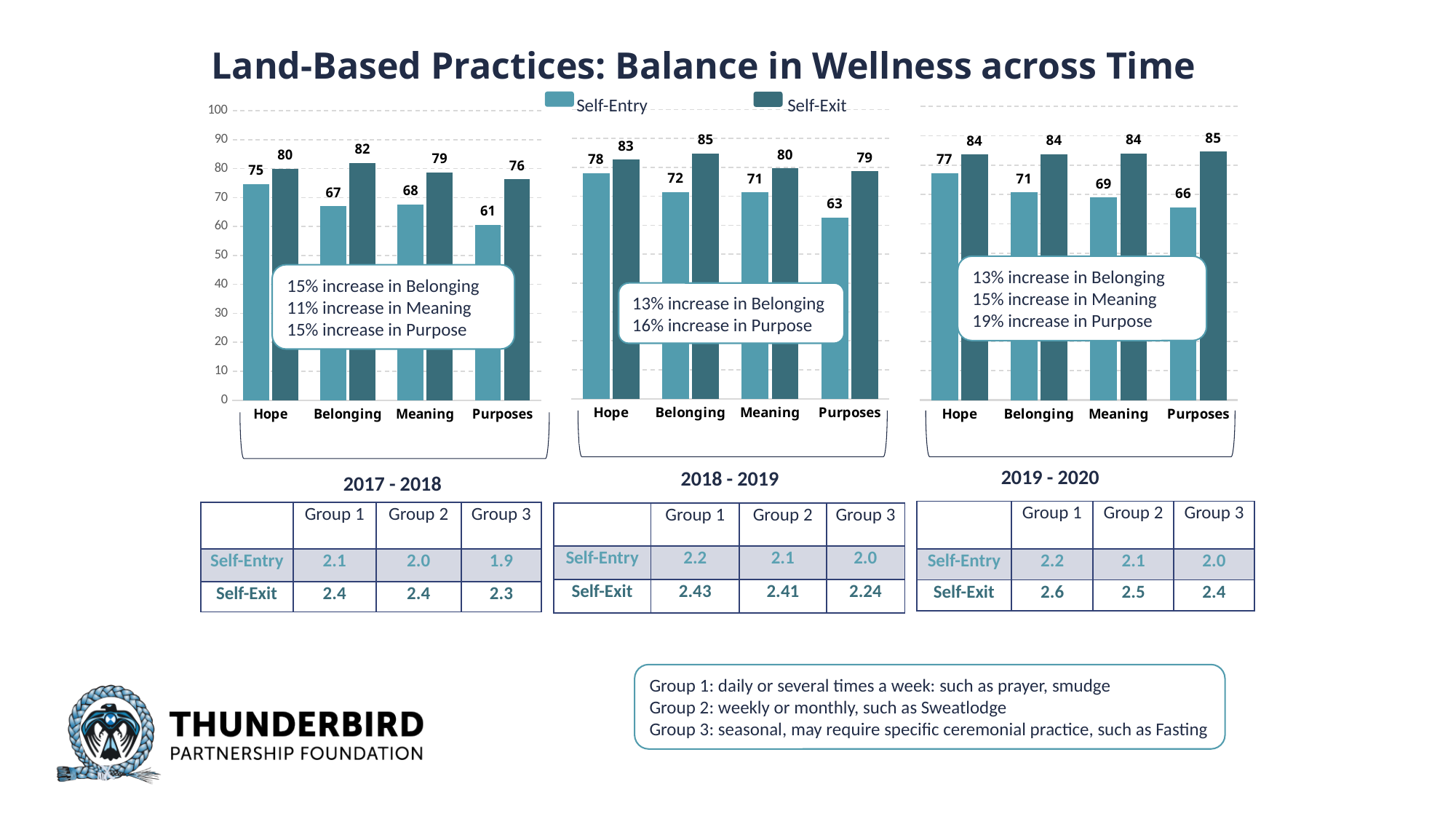
In the 2018 - 2019 chart, what is the difference between the Self-Exit and Self-Entry values for Purposes? 16 In the 2018 - 2019 chart, what is the Self-Exit value for Belonging? 85 In the 2018 - 2019 chart, is the Self-Entry value for Purposes greater or less than 70? less In the 2017 - 2018 chart, what is the Self-Entry value for Hope? 75 How many series does the legend list for the charts? 2 In the 2019 - 2020 chart, which category has the highest Self-Exit value? Purposes In the 2019 - 2020 chart, what is the Self-Entry value for Purposes? 66 In the 2017 - 2018 chart, which category has the lowest Self-Entry value? Purposes In the 2019 - 2020 chart, which is larger: the Self-Entry value for Hope or the Self-Entry value for Meaning? Hope In the 2017 - 2018 chart, what is the difference between the Self-Exit and Self-Entry values for Belonging? 15 What kind of chart is the 2017 - 2018 chart? Bar chart How many categories are shown on the x axis of the 2018 - 2019 chart? 4